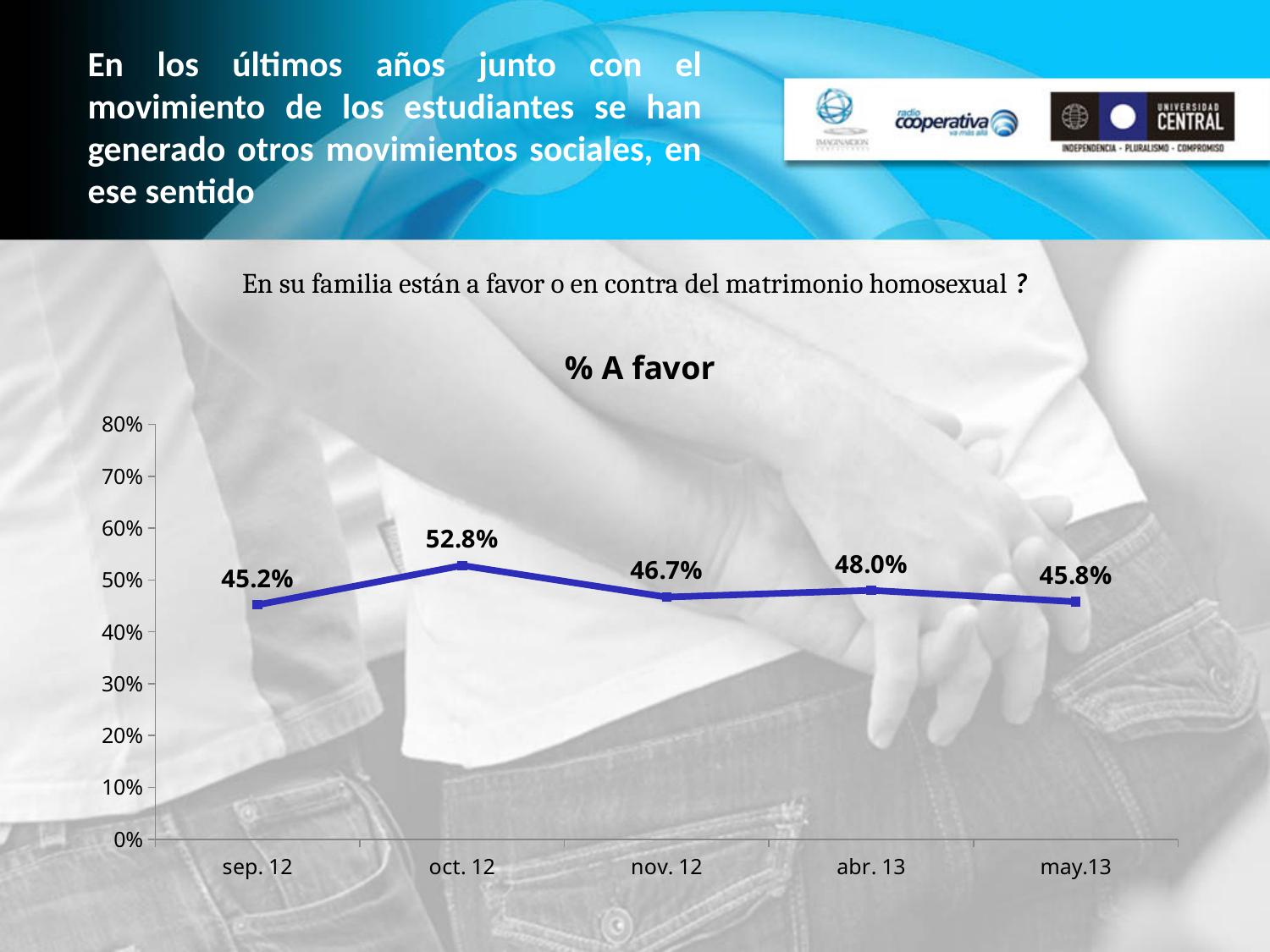
What kind of chart is shown on the slide? line chart What is the value for abr. 13? 48.0% Which period has the highest value? oct. 12 What is the title of the chart? % A favor What is the value for sep. 12? 45.2% Which is larger, the value for abr. 13 or the value for may.13? abr. 13 Is the value for oct. 12 greater or less than 50%? greater What is the value for oct. 12? 52.8% How many data points are plotted on the chart? 5 Which period has the lowest value? sep. 12 What is the value for may.13? 45.8% What is the difference between the values for oct. 12 and nov. 12? 6.1%